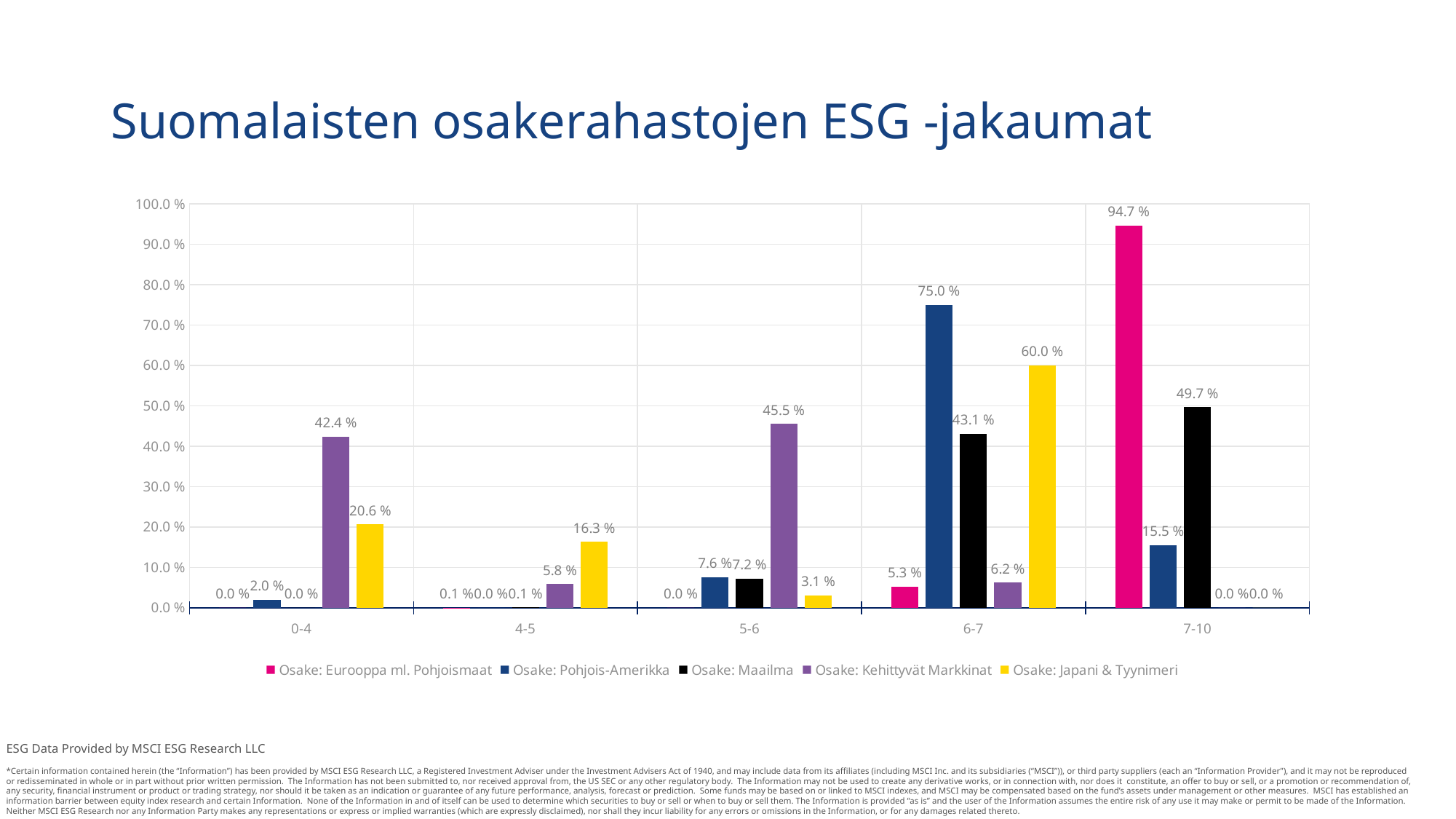
What is the value for Osake: Japani & Tyynimeri in the 4-5 category? 16.3 % What is the value for Osake: Kehittyvät Markkinat in the 0-4 category? 42.4 % In which category does Osake: Maailma have its highest value? 7-10 In which category does Osake: Kehittyvät Markkinat have its highest value? 5-6 What is the value for Osake: Pohjois-Amerikka in the 6-7 category? 75.0 % What is the title of the chart on the slide? Suomalaisten osakerahastojen ESG -jakaumat How many categories are shown on the x axis? 5 What is the difference between Osake: Pohjois-Amerikka and Osake: Japani & Tyynimeri in the 6-7 category? 15.0 % What is the value for Osake: Eurooppa ml. Pohjoismaat in the 7-10 category? 94.7 % How many series does the legend list? 5 Which is larger in the 5-6 category: Osake: Pohjois-Amerikka or Osake: Japani & Tyynimeri? Osake: Pohjois-Amerikka What kind of chart is shown on the slide? bar chart